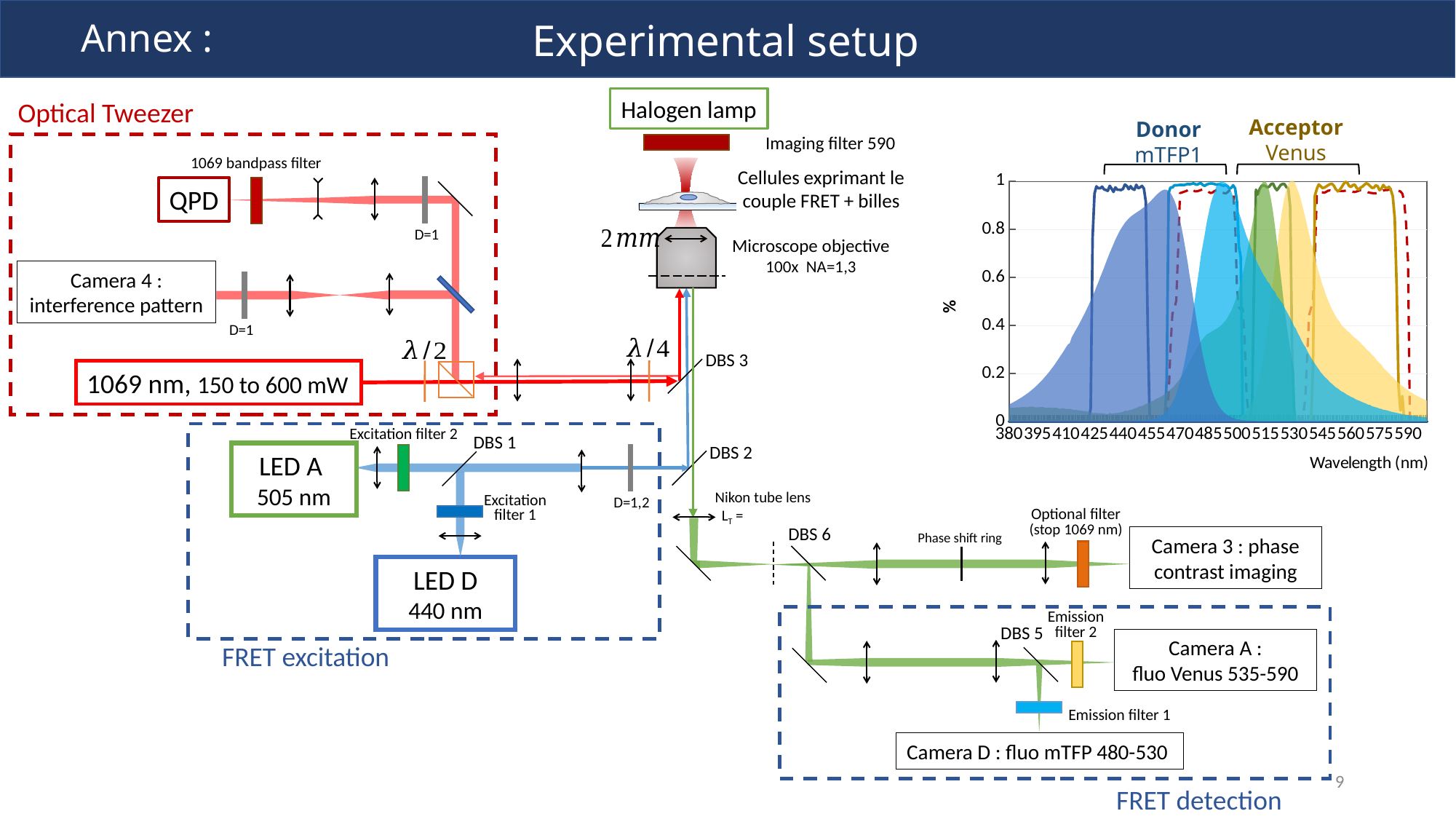
How many tick labels are shown on the x axis of the spectral chart? 15 What is the label of the y axis of the spectral chart? % Which fluorescent protein is labelled as the donor above the spectral chart? mTFP1 What is the maximum value shown on the y axis of the spectral chart? 1 Which fluorescent protein is labelled as the acceptor above the spectral chart? Venus In the spectral chart, is the dark blue filter transmission curve at 440 nm greater or less than 0.8? greater What kind of chart is shown on the right side of the slide? area chart In the spectral chart, is the dark blue filter transmission curve at 500 nm greater or less than 0.2? less What is the lowest wavelength tick shown on the x axis of the spectral chart? 380 In the spectral chart, is the yellow-brown filter transmission curve at 560 nm greater or less than 0.8? greater What is the highest wavelength tick shown on the x axis of the spectral chart? 590